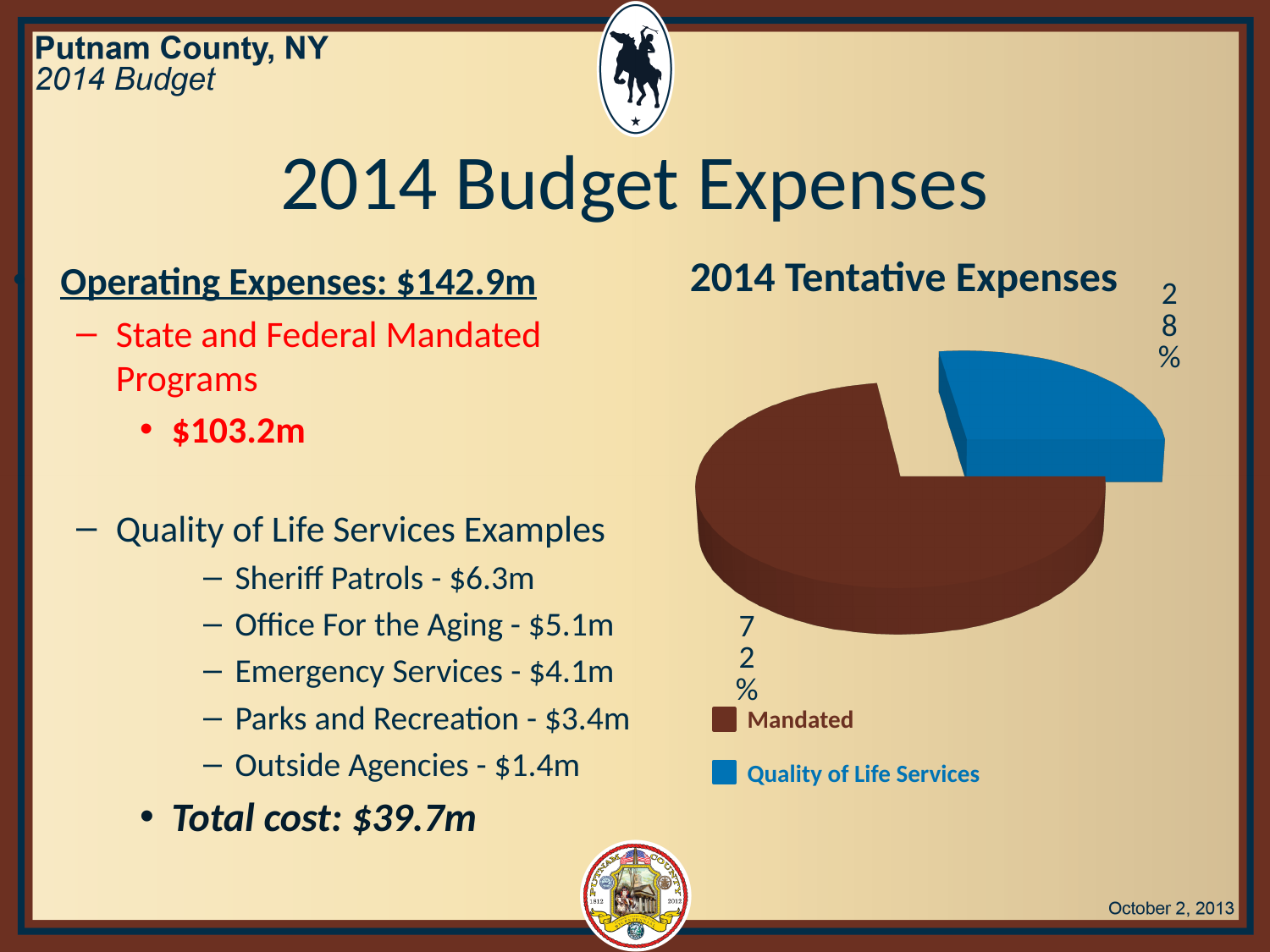
How many slices does the pie chart have? 2 What share of the pie does the Mandated slice represent? 72% How many entries does the chart legend list? 2 What is the title of the chart? 2014 Tentative Expenses What colour is the Quality of Life Services slice in the pie chart? blue What kind of chart is shown on the slide? pie chart Which slice of the pie is the largest? Mandated What is the difference in percentage points between the Mandated slice and the Quality of Life Services slice? 44 Which is larger, the Mandated slice or the Quality of Life Services slice? Mandated What share of the pie does the Quality of Life Services slice represent? 28% Which slice of the pie is the smallest? Quality of Life Services